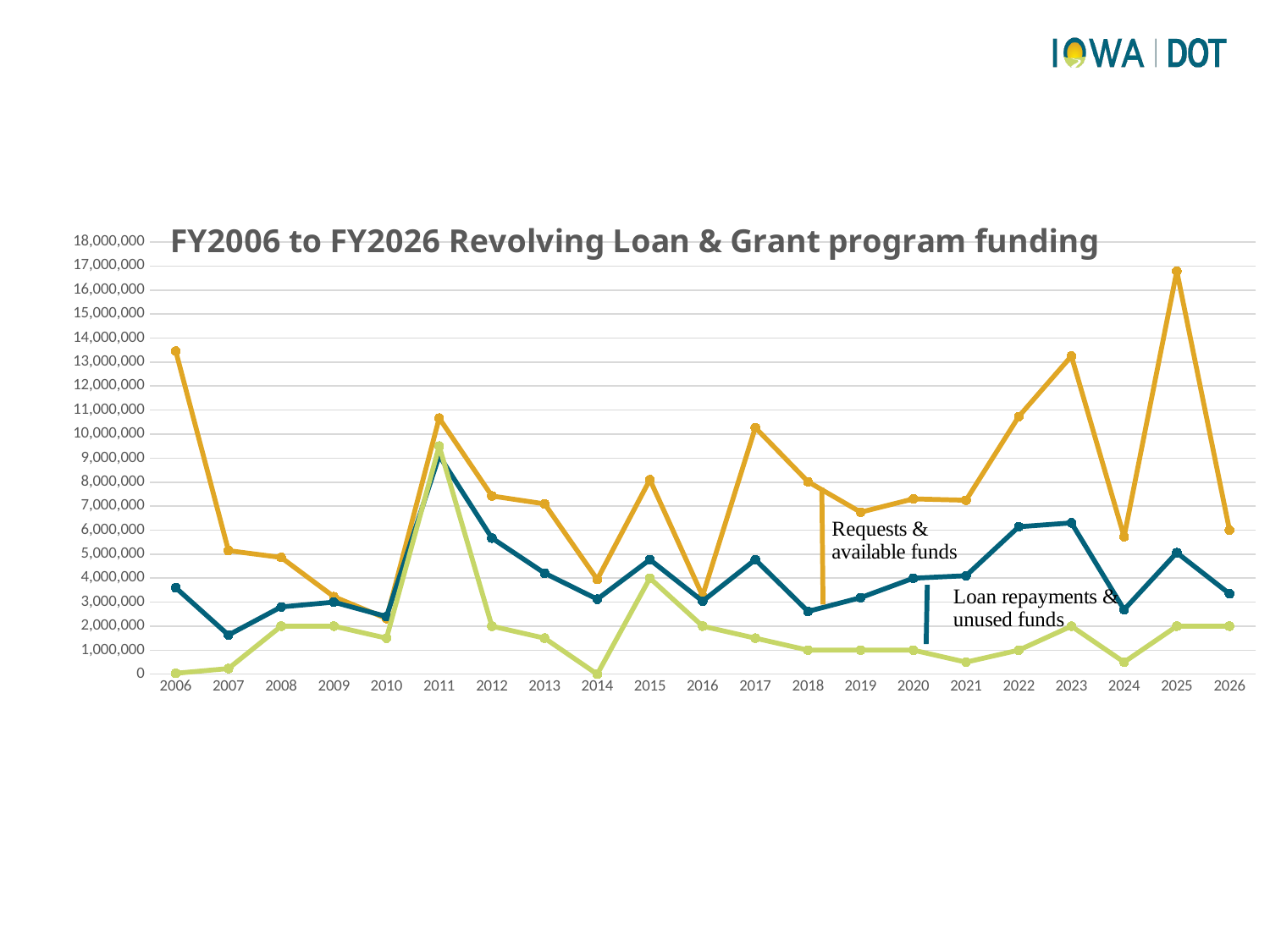
How many fiscal years are plotted along the x axis? 21 Which is larger for the orange line: the value in 2015 or the value in 2017? 2017 Is the value of the orange line in 2025 greater or less than 16,000,000? greater In which year does the orange line reach its lowest value? 2010 What kind of chart is shown on the slide? line chart What is the title of the chart? FY2006 to FY2026 Revolving Loan & Grant program funding Does the orange line rise or fall from 2006 to 2010? fall In which year does the dark teal line reach its highest value? 2011 Is the value of the orange line in 2010 greater or less than 3,000,000? less In which year does the orange line reach its highest value? 2025 How many lines are plotted on the chart? 3 In which year does the dark teal line reach its lowest value? 2007